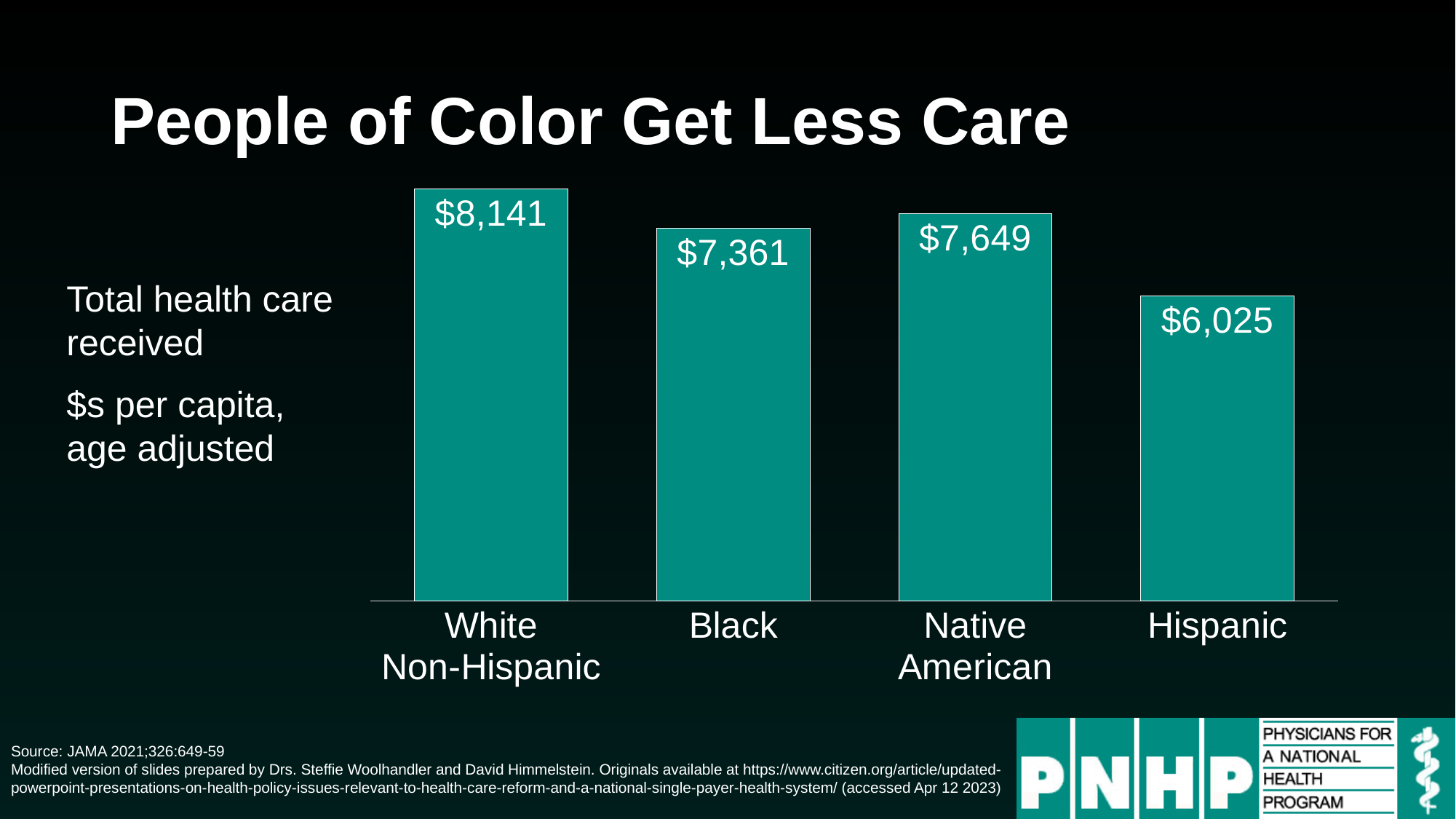
Which is larger, the value for Black or the value for Native American? Native American What is the difference between the Native American and Black values? $288 What is the difference between the White Non-Hispanic and Hispanic values? $2,116 Which group has the lowest total health care received per capita? Hispanic What is the value shown for Native American? $7,649 Which group has the highest total health care received per capita? White Non-Hispanic What is the total health care received per capita for White Non-Hispanic people? $8,141 What is the value shown for Black? $7,361 What is the value shown for Hispanic? $6,025 What kind of chart is shown on the slide? Bar chart How many groups are shown in the chart? 4 What is the title of the slide? People of Color Get Less Care